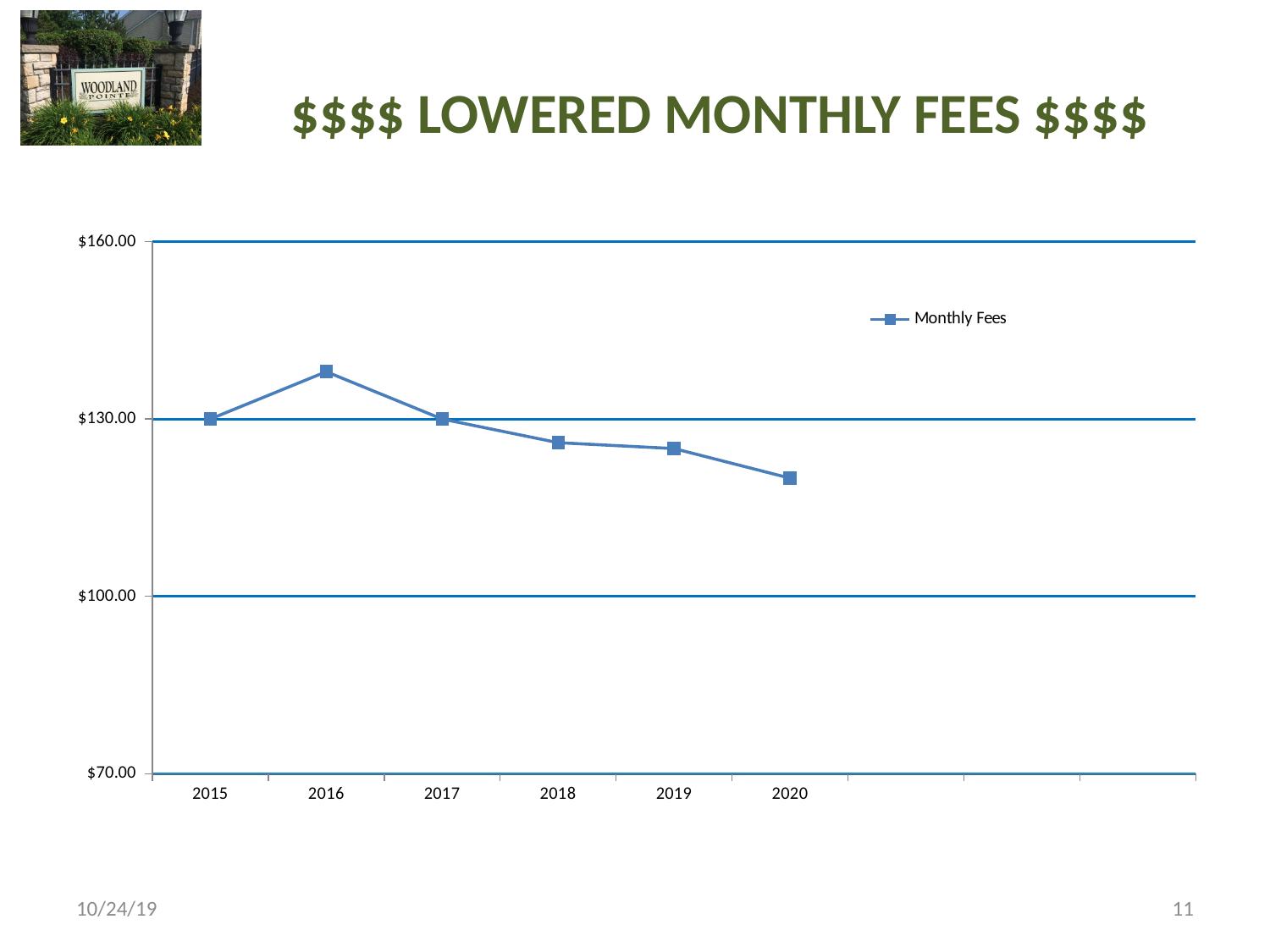
What is the name of the series shown in the legend? Monthly Fees Do the monthly fees rise or fall from 2017 to 2020? fall Which year has the larger monthly fee, 2016 or 2020? 2016 Which year has the lowest monthly fee? 2020 How many series does the legend list? 1 What kind of chart is shown on the slide? line chart Which year has the highest monthly fee? 2016 Is the monthly fee for 2016 greater or less than $130.00? greater What is the monthly fee for 2015? $130.00 How many years are plotted on the x axis? 6 Is the monthly fee for 2020 greater or less than $130.00? less What is the monthly fee for 2017? $130.00